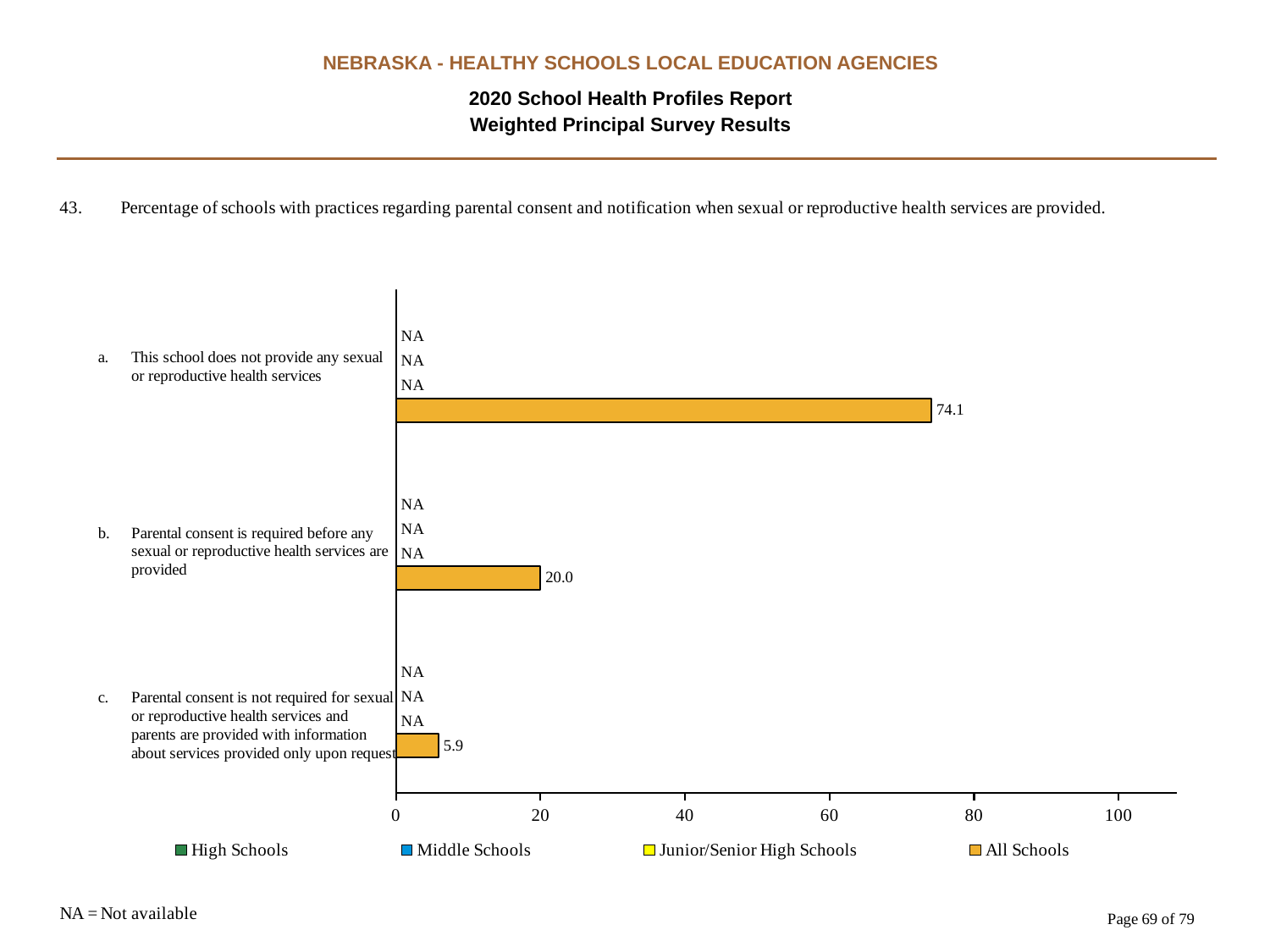
Is the All Schools value for category a greater or less than 60? greater What is the All Schools value for category a, "This school does not provide any sexual or reproductive health services"? 74.1 What is the difference between the All Schools values for category a and category b? 54.1 How many series does the legend list? 4 Which category has the lowest All Schools value? c. Parental consent is not required for sexual or reproductive health services and parents are provided with information about services provided only upon request Which is larger for All Schools: category b or category c? category b Which category has the highest All Schools value? a. This school does not provide any sexual or reproductive health services What value is shown for High Schools in category a? NA What kind of chart is shown on the slide? bar chart How many categories (practices) are shown on the chart? 3 What is the All Schools value for category c, "Parental consent is not required ... only upon request"? 5.9 What is the All Schools value for category b, "Parental consent is required before any sexual or reproductive health services are provided"? 20.0